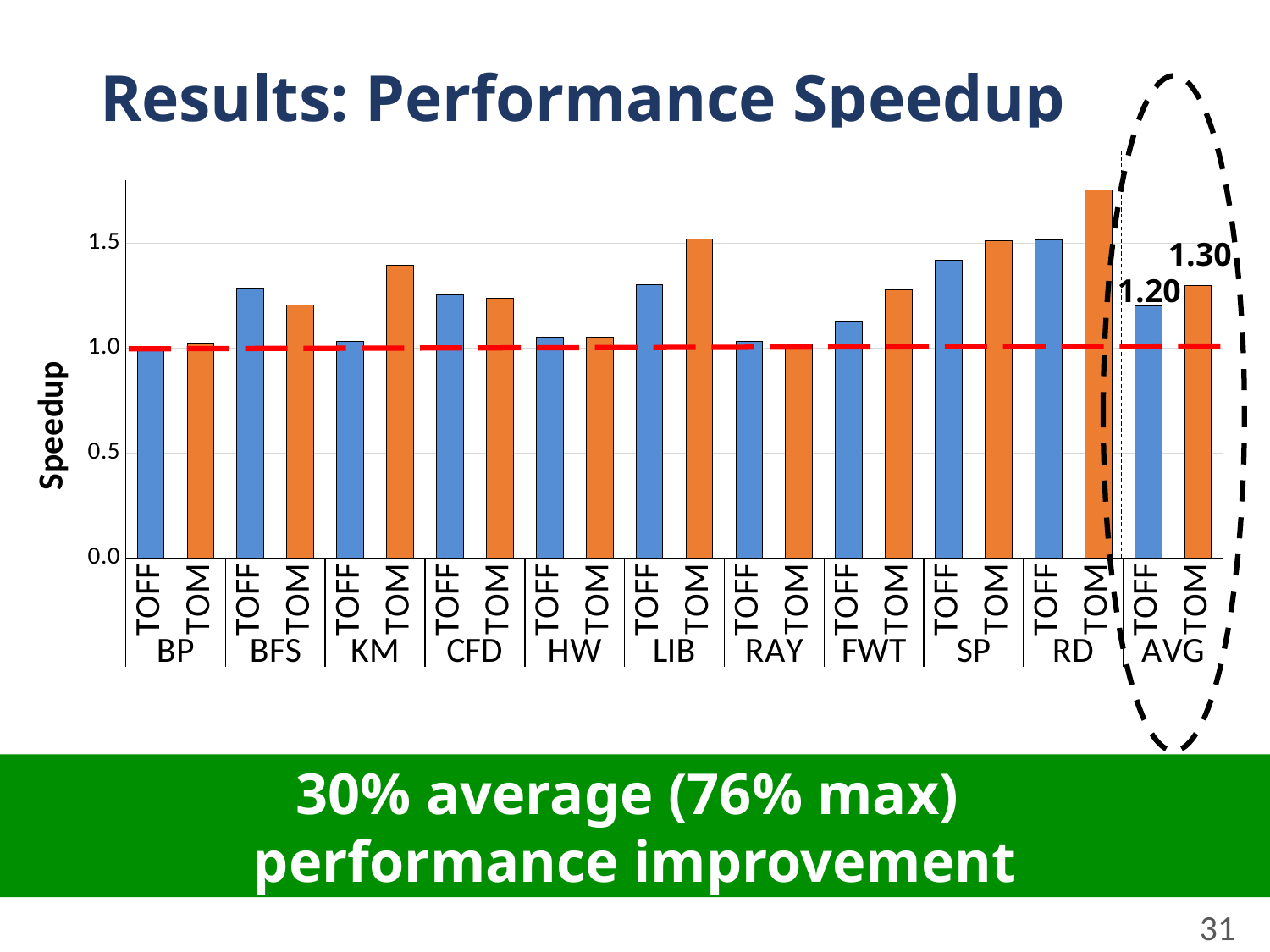
What is the label of the y axis? Speedup In the KM group, which bar is larger, TOFF or TOM? TOM What is the difference between the TOM and TOFF speedup values in the AVG group? 0.10 What kind of chart is shown on the slide? bar chart In the AVG group, which bar is larger, TOFF or TOM? TOM How many benchmark groups are shown along the x axis? 11 Is the speedup for the TOFF bar in the RD group greater or less than 1.0? greater What is the speedup value for the TOFF bar in the AVG group? 1.20 Is the speedup for the TOM bar in the RD group greater or less than 1.5? greater Which bar has the highest speedup in the chart? TOM for RD Is the speedup for the TOM bar in the KM group greater or less than 1.5? less What is the speedup value for the TOM bar in the AVG group? 1.30